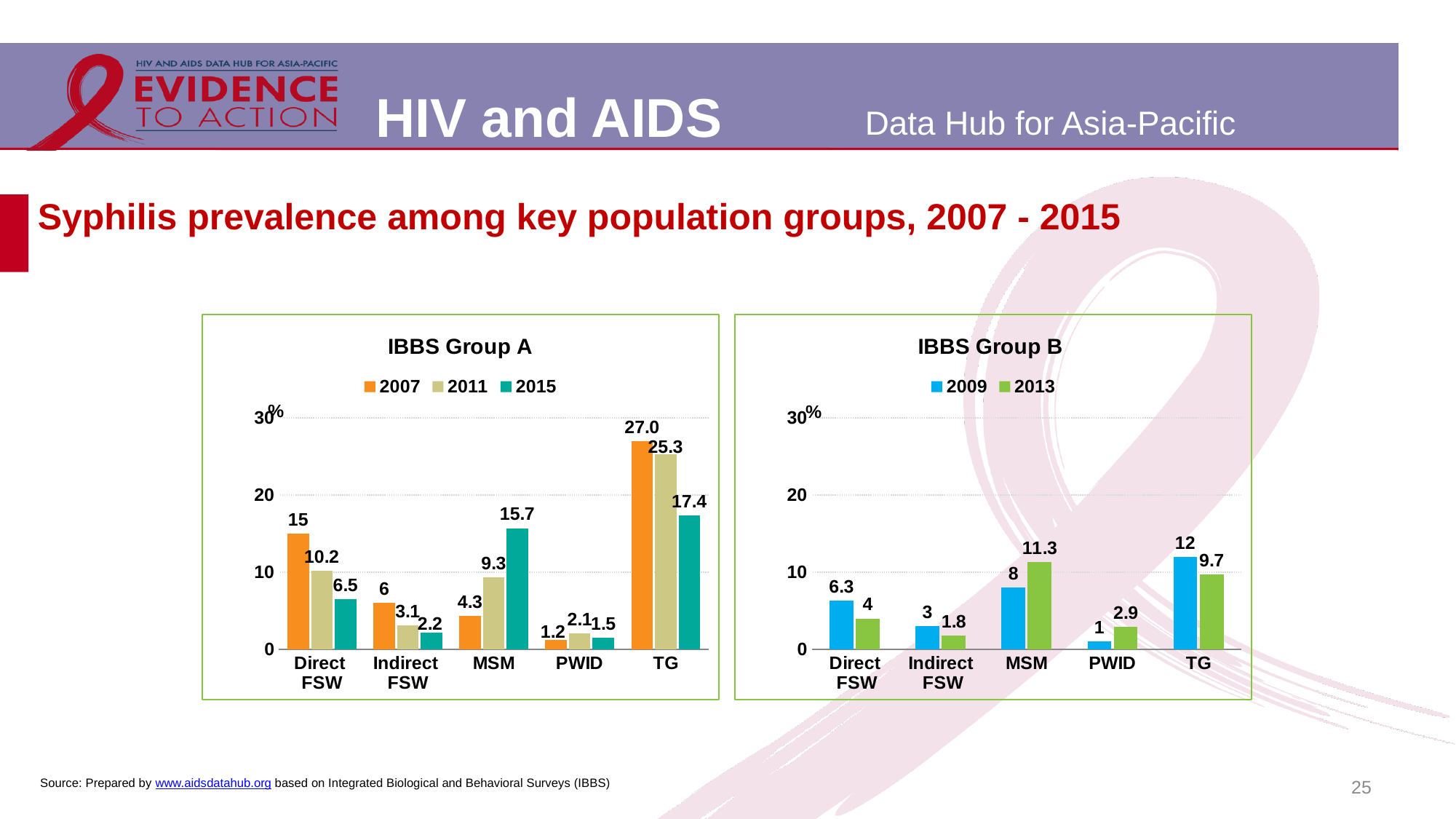
In the IBBS Group A chart, what is the value for Direct FSW in 2011? 10.2 In the IBBS Group B chart, what is the difference between the 2009 and 2013 values for Direct FSW? 2.3 In the IBBS Group B chart, is the value for TG in 2009 greater or less than 10? greater In the IBBS Group B chart, what is the value for MSM in 2013? 11.3 In the IBBS Group B chart, which category has the highest value in 2009? TG What type of chart is the IBBS Group B chart? Bar chart In the IBBS Group A chart, what is the value for TG in 2007? 27.0 In the IBBS Group A chart, which is larger for MSM: the 2011 value or the 2015 value? 2015 How many categories are shown on the x axis of the IBBS Group B chart? 5 In the IBBS Group A chart, what is the difference between the 2007 and 2015 values for TG? 9.6 How many series does the legend of the IBBS Group A chart list? 3 In the IBBS Group A chart, which category has the lowest value in 2015? PWID